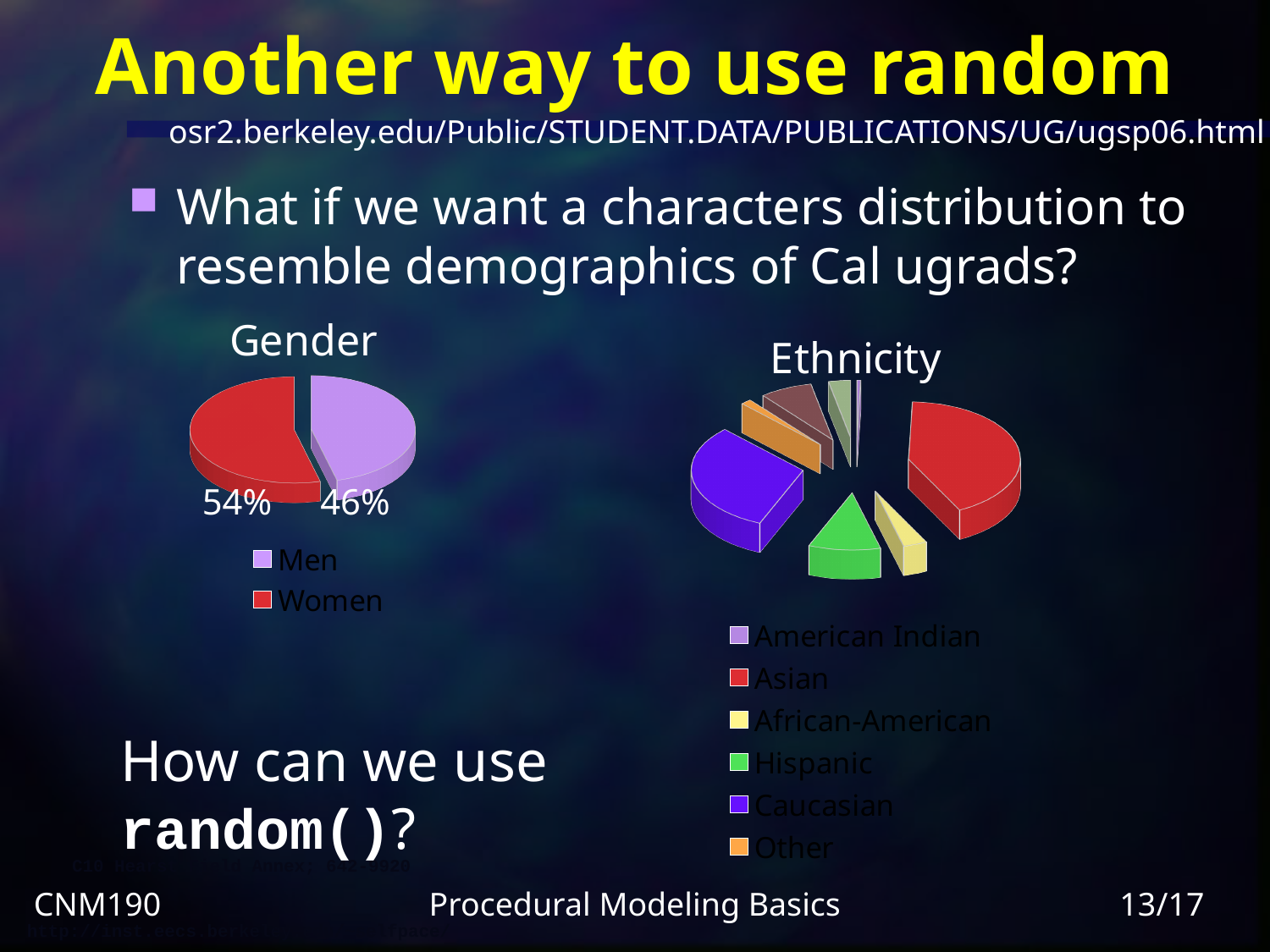
In the Gender chart, which category has the larger share? Women In the Gender chart, what percentage is shown for Women? 54% How many categories does the Gender chart's legend list? 2 In the Ethnicity chart, which slice is larger, Asian or Hispanic? Asian In the Gender chart, is the share for Women greater or less than 50%? greater What kind of chart is the Gender chart? pie chart In the Gender chart, which category has the smaller share? Men In the Ethnicity chart, which slice is larger, Caucasian or African-American? Caucasian In the Ethnicity chart, which category has the largest slice? Asian In the Gender chart, what is the difference between the Women and Men percentages? 8% In the Ethnicity chart, what colour represents Asian? red In the Gender chart, what percentage is shown for Men? 46%